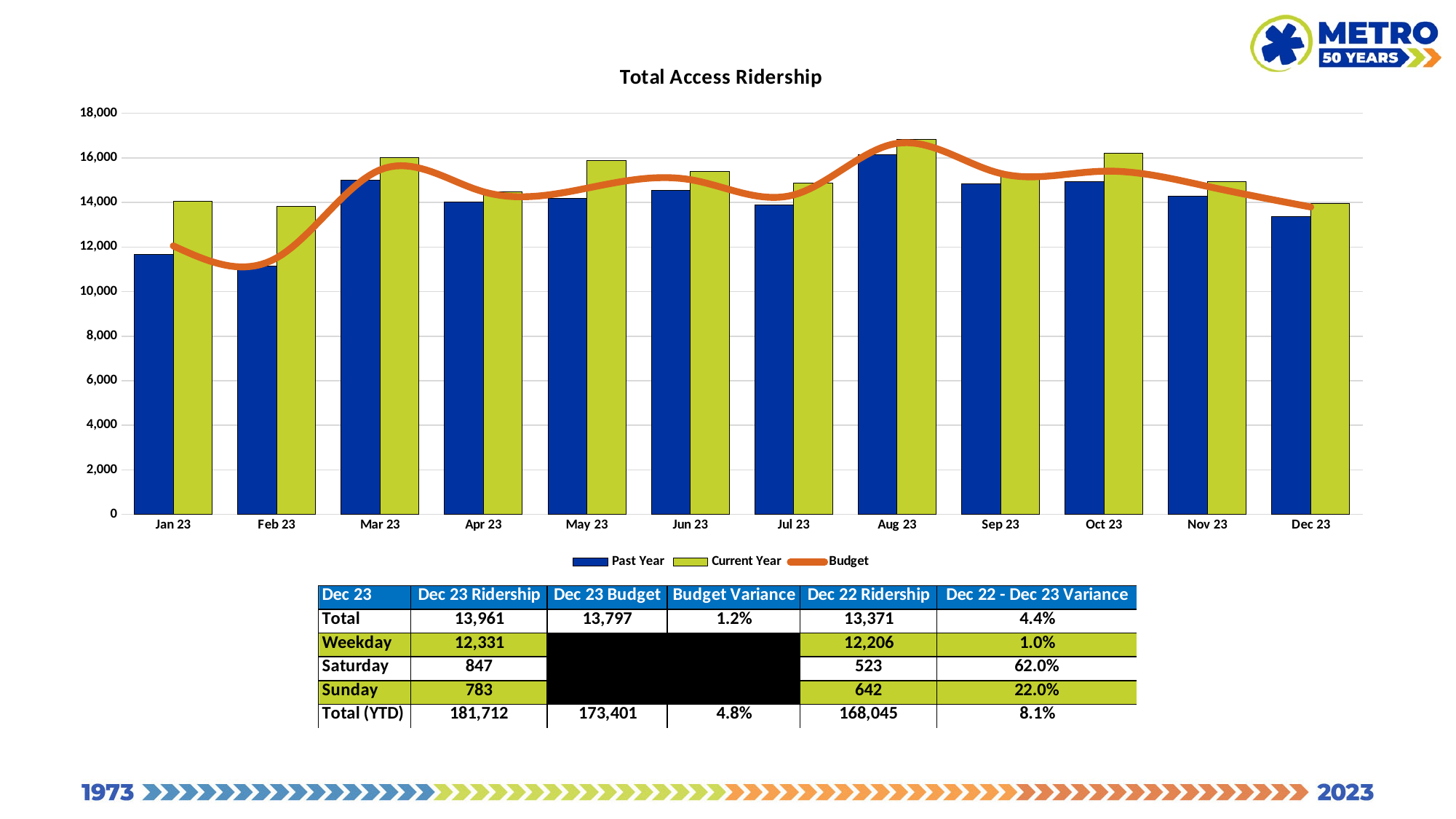
Which month has the highest Current Year bar? Aug 23 What is the title of the chart? Total Access Ridership What kind of chart is shown on the slide? bar chart with a line How many series does the chart legend list? 3 Which colour represents the Past Year series in the chart? blue How many months are shown along the x axis of the chart? 12 Is the Past Year value for Jan 23 greater or less than 12,000? less Is the Current Year value for Aug 23 greater or less than 16,000? greater Which month has the lowest Past Year bar? Feb 23 Which month has the highest Past Year bar? Aug 23 Does the Budget line rise or fall from Aug 23 to Dec 23? fall In Jan 23, which is larger, the Past Year bar or the Current Year bar? Current Year